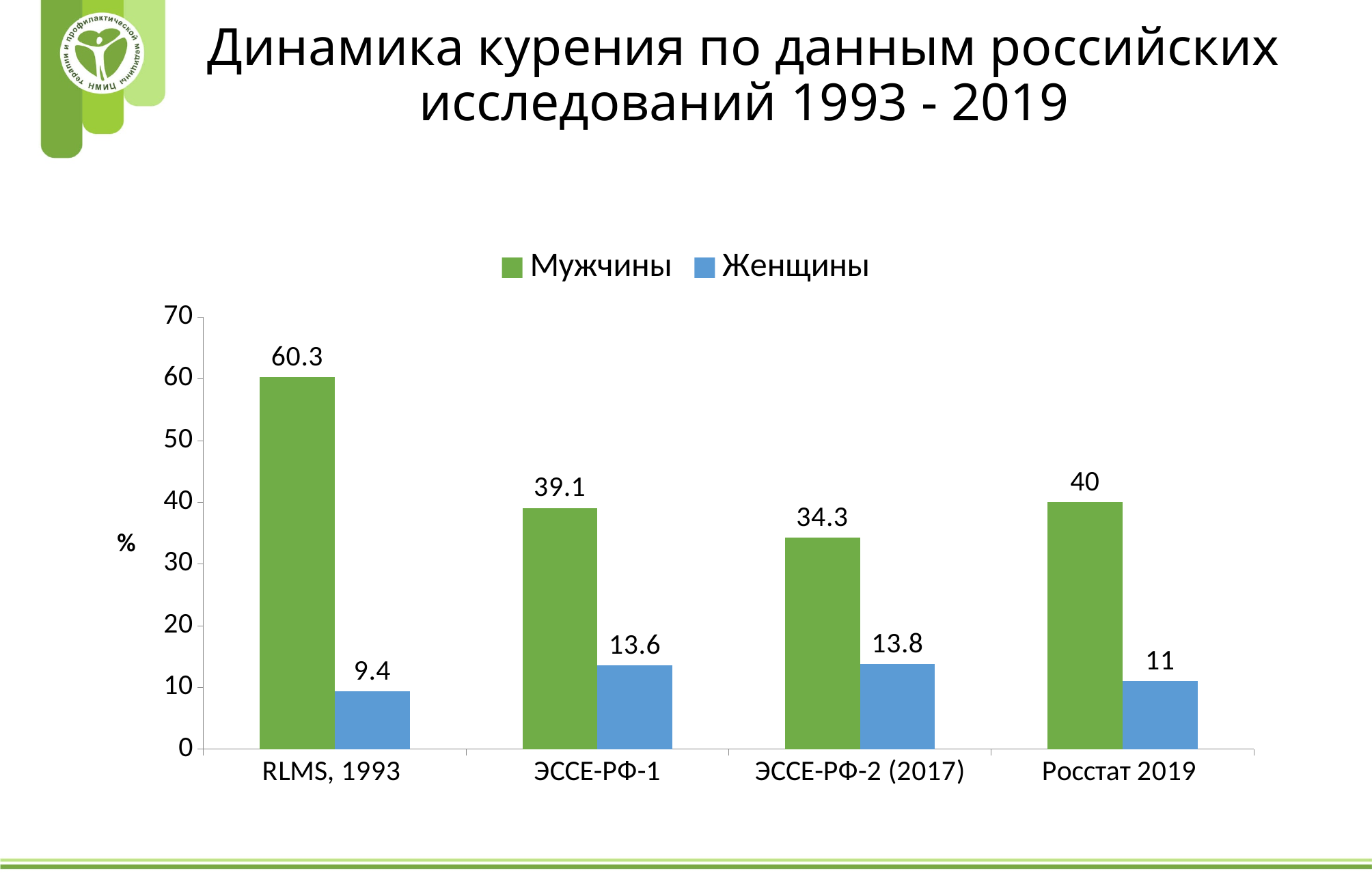
Is the value for Мужчины in ЭССЕ-РФ-2 (2017) greater or less than 30? greater What is the value for Мужчины in Росстат 2019? 40 What is the value for Мужчины in RLMS, 1993? 60.3 What is the difference between the Мужчины and Женщины values in ЭССЕ-РФ-1? 25.5 What colour are the bars for Женщины? blue What kind of chart is shown on the slide? bar chart How many series does the legend list? 2 What is the value for Женщины in ЭССЕ-РФ-2 (2017)? 13.8 Which category has the lowest value for Женщины? RLMS, 1993 Which category has the highest value for Мужчины? RLMS, 1993 Which is larger: the Мужчины value in ЭССЕ-РФ-1 or in Росстат 2019? Росстат 2019 How many categories are shown on the x axis? 4